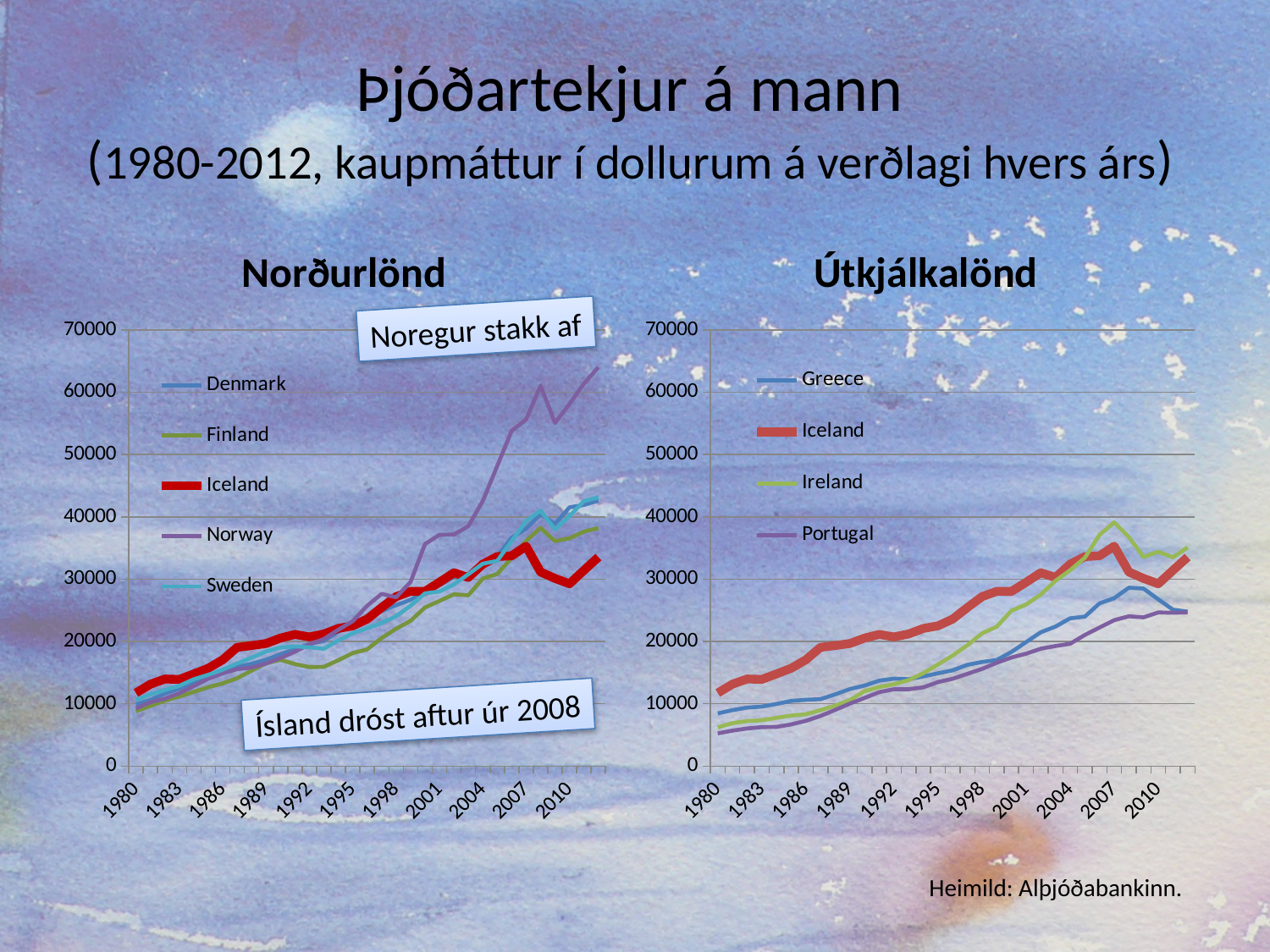
In the Norðurlönd chart, is the value for Norway in 2012 greater or less than 60000? greater In the Útkjálkalönd chart, is the value for Portugal in 2012 greater or less than 30000? less How many series does the legend of the Útkjálkalönd chart list? 4 How many series does the legend of the Norðurlönd chart list? 5 In the Útkjálkalönd chart, which country has the lowest value in 1980? Portugal Which country appears in the legends of both charts? Iceland What is the title of the chart on the right? Útkjálkalönd What kind of chart is the Norðurlönd chart on the left? line chart In the Norðurlönd chart, which country has the highest value at the end of the period (2012)? Norway In the Norðurlönd chart, is the value for Iceland in 2012 greater or less than 30000? greater In the Útkjálkalönd chart, which is larger in 2012, the value for Iceland or the value for Greece? Iceland In the Norðurlönd chart, does the value for Norway generally rise or fall from 1980 to 2012? rise